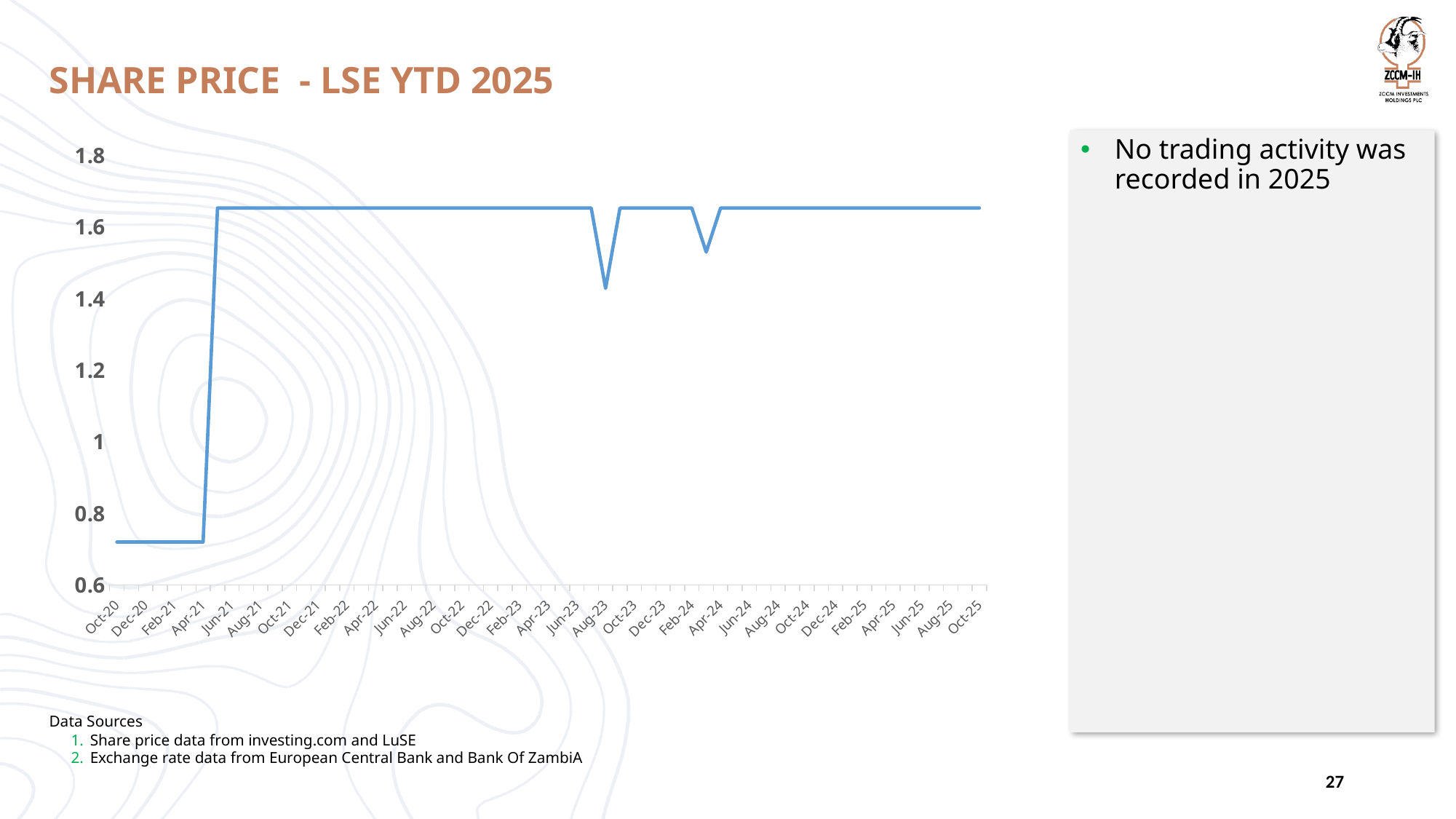
How many date labels are shown on the x axis? 31 Is the share price value at the dip around Aug-23 greater or less than 1.6? less What kind of chart is shown on the slide? Line chart What is the first date label on the x axis? Oct-20 Which is larger, the share price at Oct-20 or at Oct-25? Oct-25 Which is larger, the share price at Jun-23 or at the dip around Aug-23? Jun-23 Is the share price value at Oct-20 greater or less than 0.8? less Is the share price value at Dec-22 greater or less than 1.4? greater Does the share price rise or fall between Apr-21 and Jun-21? Rise What is the title of the slide's chart? SHARE PRICE - LSE YTD 2025